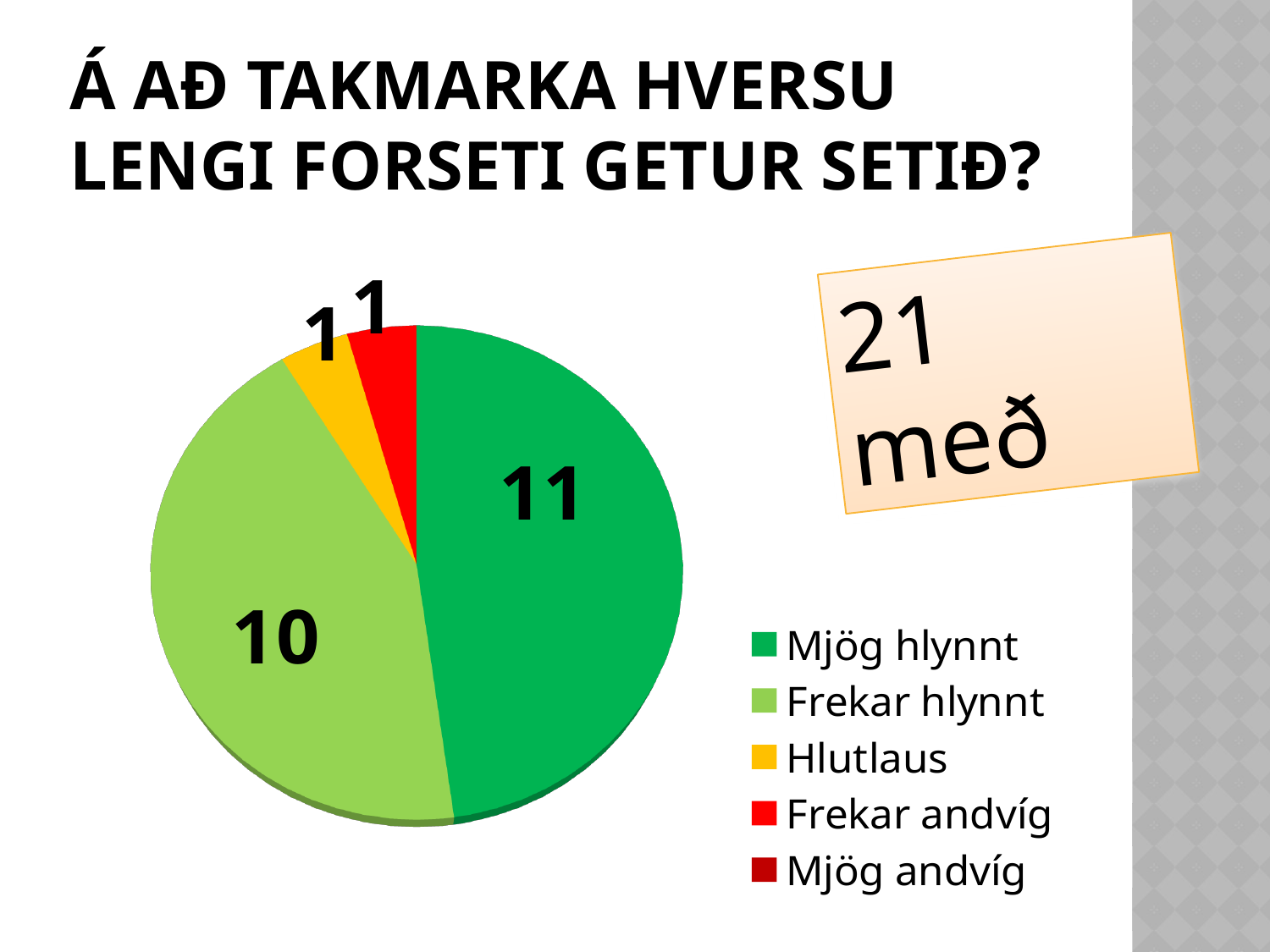
Which category has the largest slice of the pie? Mjög hlynnt What is the title of the slide? Á AÐ TAKMARKA HVERSU LENGI FORSETI GETUR SETIÐ? What is the difference between the values for Mjög hlynnt and Frekar hlynnt? 1 What colour is the Mjög hlynnt slice? green What type of chart is shown on the slide? pie chart What is the value for Hlutlaus? 1 How many slices with a visible data label does the pie chart have? 4 What is the value for Frekar hlynnt? 10 What is the value for Mjög hlynnt? 11 What is the value for Frekar andvíg? 1 How many entries does the legend list? 5 Which is larger, the value for Mjög hlynnt or the value for Frekar hlynnt? Mjög hlynnt